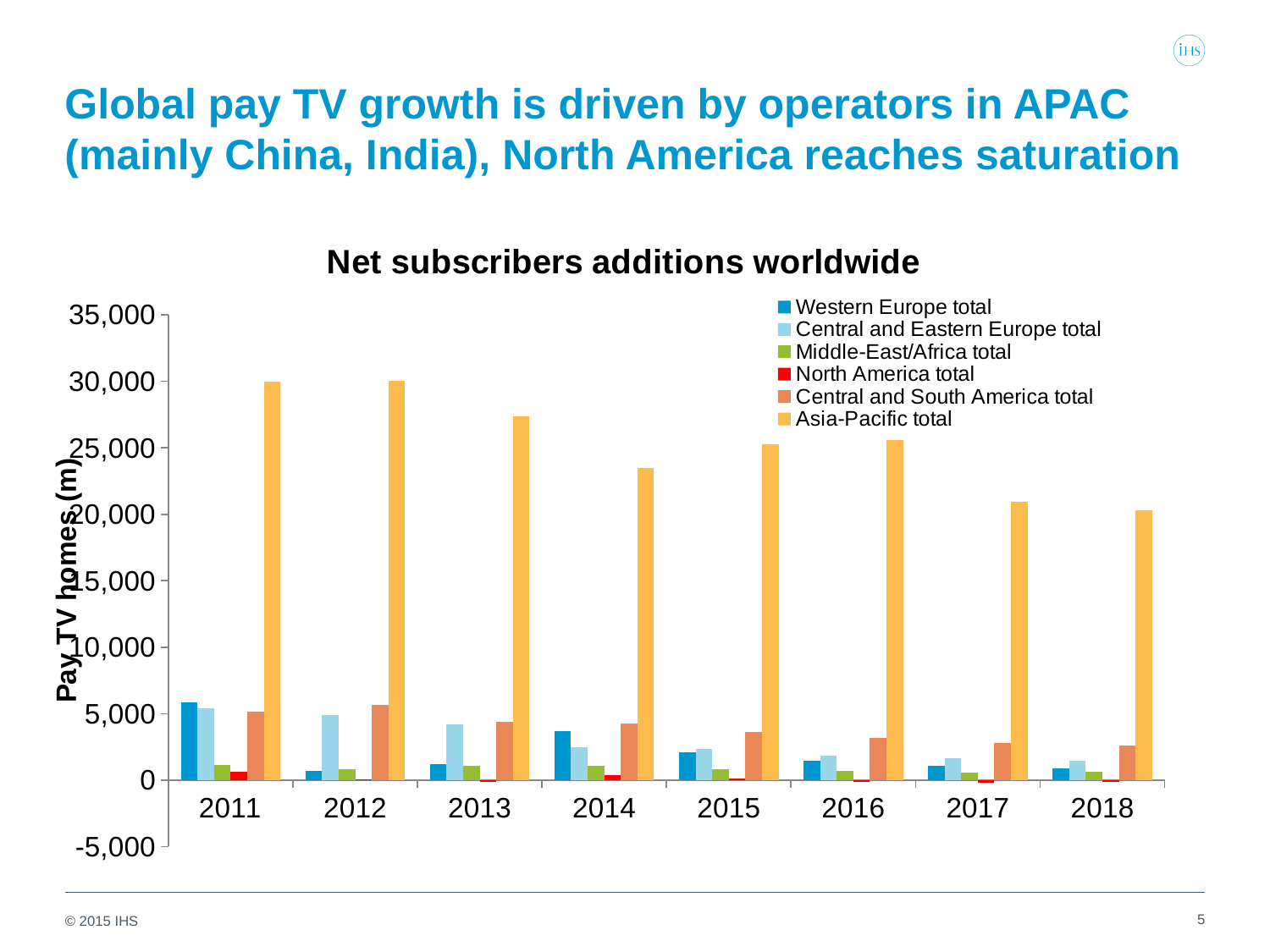
What kind of chart is shown on the slide? bar chart What is the title of the chart? Net subscribers additions worldwide How many years are shown on the x axis? 8 Which series has the highest value in 2011? Asia-Pacific total Which is larger for Western Europe total: the value in 2011 or the value in 2012? 2011 Is the value for Central and South America total in 2012 greater or less than 5,000? greater Do the values for Central and Eastern Europe total rise or fall from 2011 to 2018? fall Is the value for Asia-Pacific total in 2011 greater or less than 25,000? greater How many series does the legend list? 6 Which is larger for Asia-Pacific total: the value in 2013 or the value in 2014? 2013 Is the value for Asia-Pacific total in 2018 greater or less than 25,000? less In which year is the Western Europe total highest? 2011